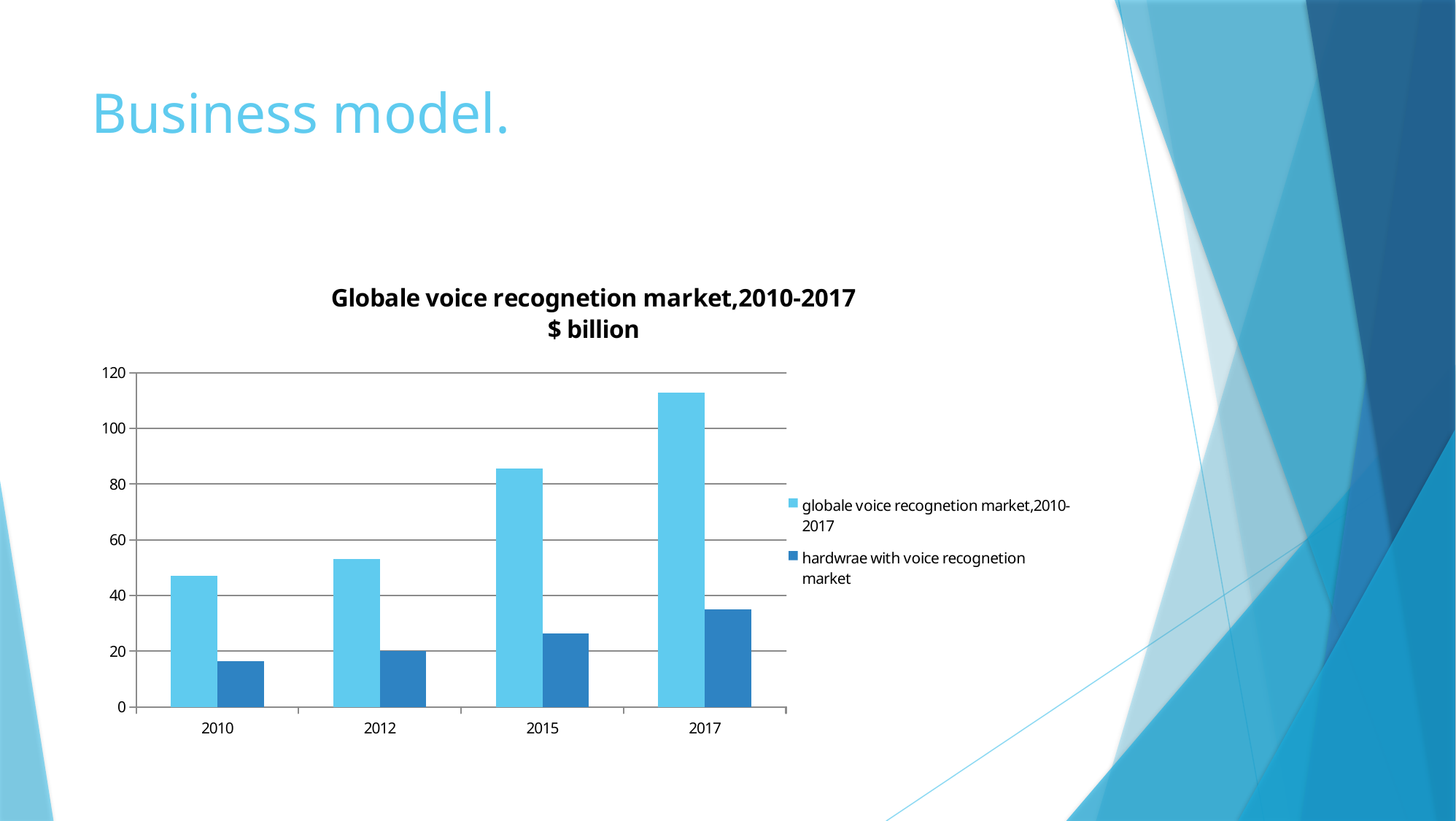
Is the value for the globale voice recognetion market in 2017 greater or less than 100? greater Do the values for the globale voice recognetion market series rise or fall from 2010 to 2017? rise Which series is drawn in the darker blue colour? hardwrae with voice recognetion market How many series does the chart's legend list? 2 Which year has the highest value for the globale voice recognetion market series? 2017 How many years are shown on the x axis of the chart? 4 Is the value for the globale voice recognetion market in 2015 greater or less than 80? greater Which year has the lowest value for the hardwrae with voice recognetion market series? 2010 What kind of chart is shown on the slide? bar chart Is the value for the hardwrae with voice recognetion market in 2010 greater or less than 20? less Which is larger in 2012: the globale voice recognetion market or the hardwrae with voice recognetion market? globale voice recognetion market What is the title of the chart? Globale voice recognetion market,2010-2017 $ billion